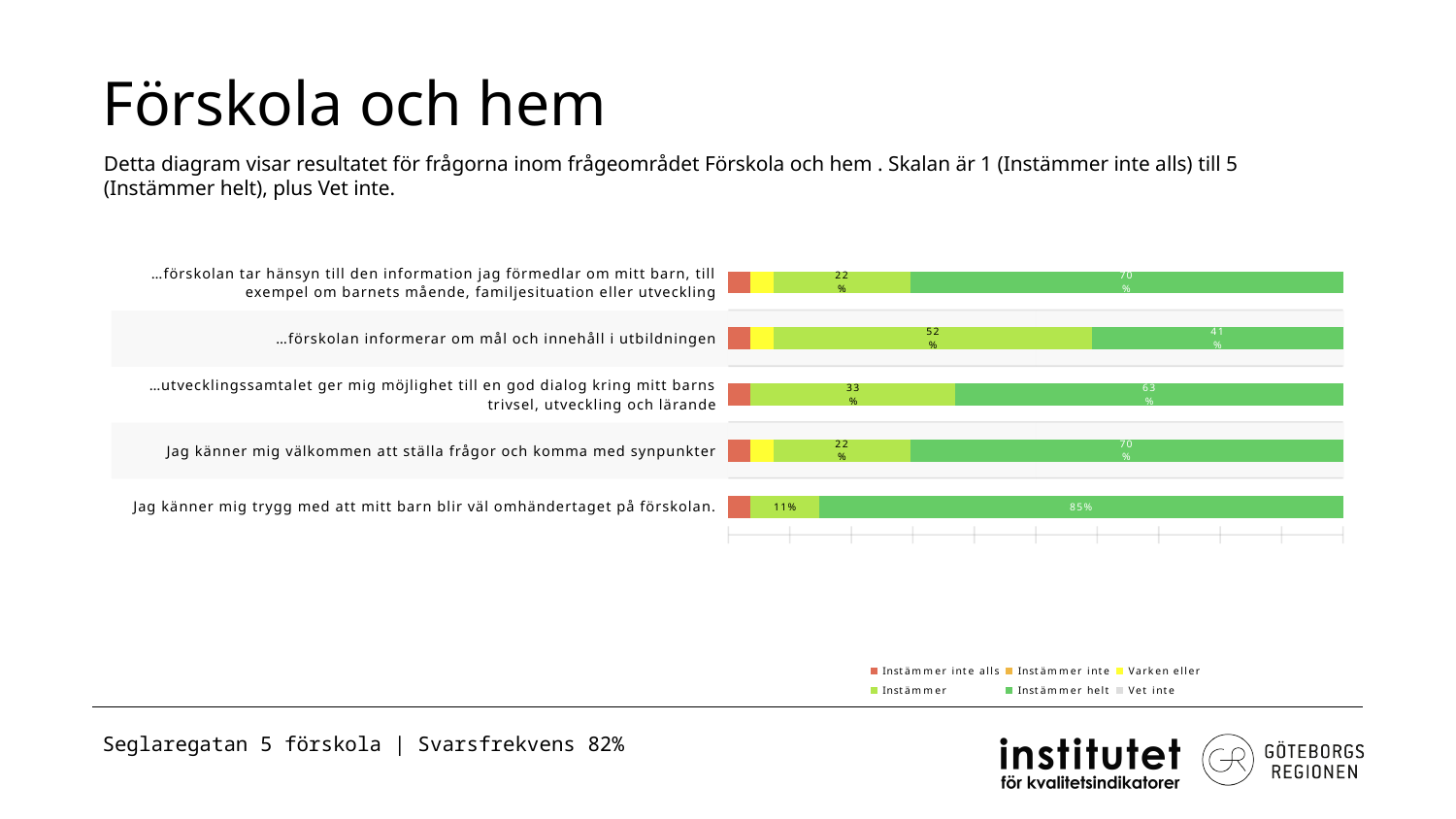
What is the 'Instämmer helt' value for 'Jag känner mig välkommen att ställa frågor och komma med synpunkter'? 70% What is the 'Instämmer' value for '…förskolan informerar om mål och innehåll i utbildningen'? 52% Which statement has the highest 'Instämmer helt' value? Jag känner mig trygg med att mitt barn blir väl omhändertaget på förskolan. For '…förskolan informerar om mål och innehåll i utbildningen', which is larger: the 'Instämmer' value or the 'Instämmer helt' value? Instämmer How many series does the legend list? 6 What is the difference between the 'Instämmer helt' values for 'Jag känner mig trygg med att mitt barn blir väl omhändertaget på förskolan.' and '…förskolan informerar om mål och innehåll i utbildningen'? 44% How many statements (categories) are plotted in the chart? 5 What is the 'Instämmer helt' value for '…utvecklingssamtalet ger mig möjlighet till en god dialog kring mitt barns trivsel, utveckling och lärande'? 63% What is the 'Instämmer' value for 'Jag känner mig trygg med att mitt barn blir väl omhändertaget på förskolan.'? 11% Which statement has the lowest 'Instämmer helt' value? …förskolan informerar om mål och innehåll i utbildningen What is the 'Instämmer helt' value for 'Jag känner mig trygg med att mitt barn blir väl omhändertaget på förskolan.'? 85% What kind of chart is shown on the slide? Stacked bar chart